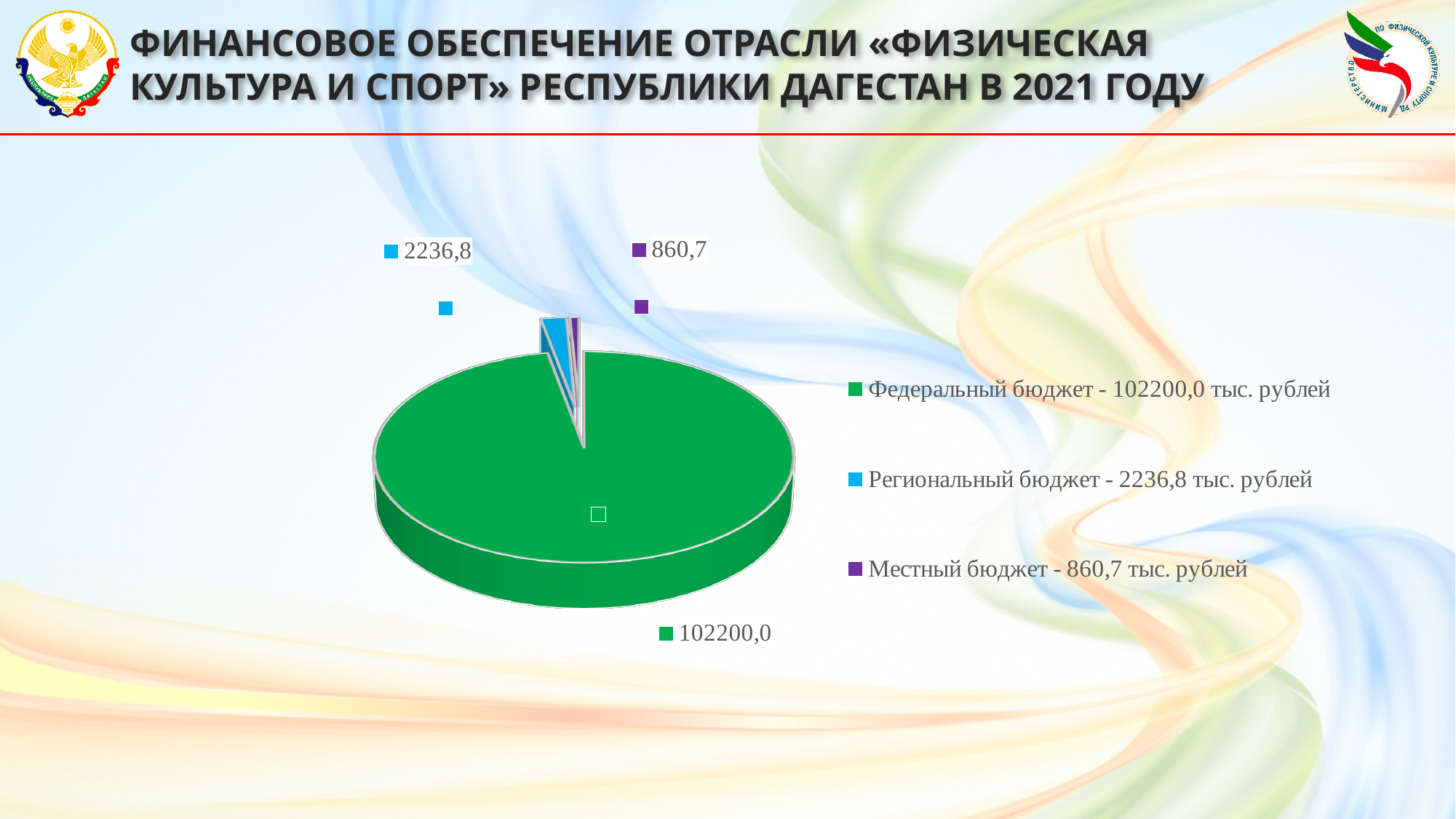
What is the value for Местный бюджет? 860,7 What is the difference between the values for Региональный бюджет and Местный бюджет? 1376,1 What type of chart is shown on the slide? Pie chart Which budget source has the smallest slice of the pie? Местный бюджет How many slices does the pie chart have? 3 Which is larger, the value for Региональный бюджет or the value for Местный бюджет? Региональный бюджет What colour is the slice for Федеральный бюджет? Green What is the total of all three values shown in the pie chart? 105297,5 What is the difference between the values for Федеральный бюджет and Региональный бюджет? 99963,2 What is the value for Региональный бюджет? 2236,8 Which budget source has the largest slice of the pie? Федеральный бюджет What is the value for Федеральный бюджет? 102200,0